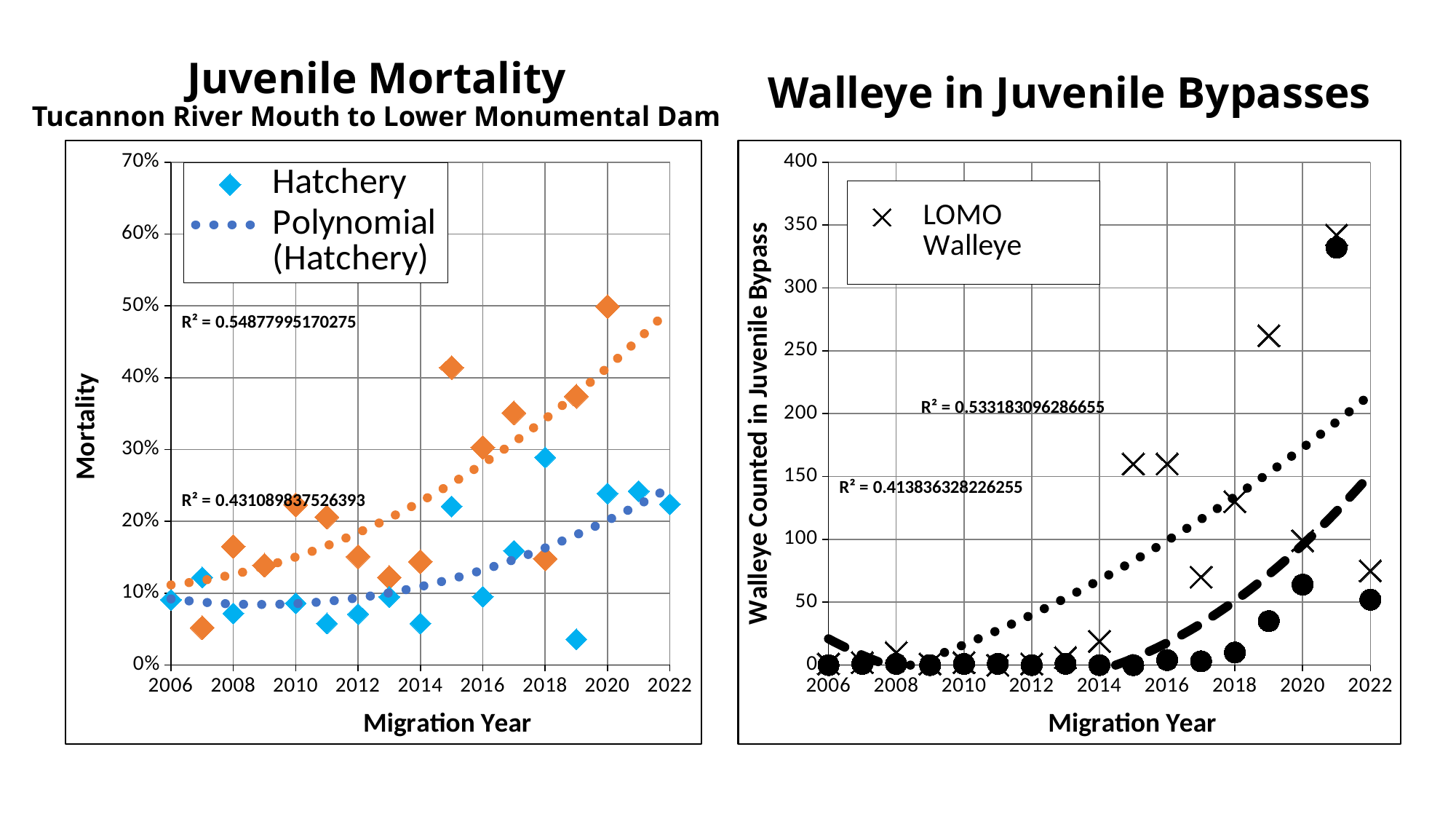
In the Juvenile Mortality chart, does the Polynomial (Hatchery) trend line rise or fall from 2006 to 2022? rise In the Juvenile Mortality chart, which migration year has the lowest Hatchery mortality? 2019 In the Juvenile Mortality chart, is the Hatchery mortality for 2019 greater or less than 10%? less In the Juvenile Mortality chart, is the Hatchery mortality for 2018 greater or less than 20%? greater In the Juvenile Mortality chart, what is the R² value printed near the top of the plot area? 0.54877995170275 In the Walleye in Juvenile Bypasses chart, is the LOMO Walleye count for 2019 greater or less than 200? greater In the Walleye in Juvenile Bypasses chart, which is larger, the LOMO Walleye count for 2021 or for 2022? 2021 What kind of chart is the Juvenile Mortality chart? scatter chart In the Walleye in Juvenile Bypasses chart, which migration year has the highest LOMO Walleye count? 2021 In the Juvenile Mortality chart, which migration year has the highest Hatchery mortality? 2018 How many entries does the legend of the Juvenile Mortality chart list? 2